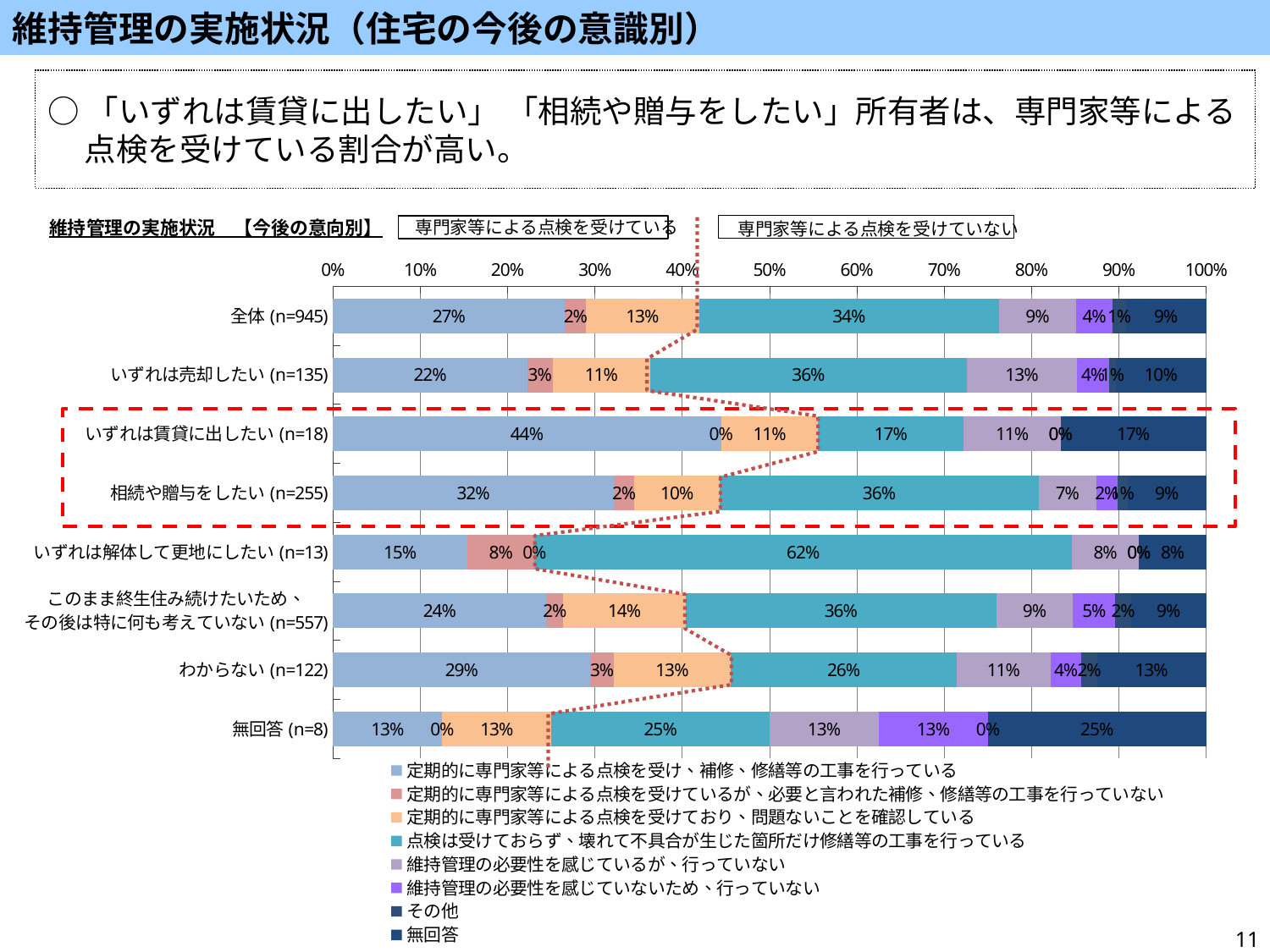
How many series does the legend list? 8 What kind of chart is shown on the slide? Stacked bar chart Which is larger for 点検は受けておらず、壊れて不具合が生じた箇所だけ修繕等の工事を行っている: 全体 (n=945) or 相続や贈与をしたい (n=255)? 相続や贈与をしたい (n=255) Which category has the highest value for 点検は受けておらず、壊れて不具合が生じた箇所だけ修繕等の工事を行っている? いずれは解体して更地にしたい (n=13) What is the value for 全体 (n=945) in the series 定期的に専門家等による点検を受け、補修、修繕等の工事を行っている? 27% What is the difference between いずれは賃貸に出したい (n=18) and 全体 (n=945) in the series 定期的に専門家等による点検を受け、補修、修繕等の工事を行っている? 17 percentage points What is the value for わからない (n=122) in the series 点検は受けておらず、壊れて不具合が生じた箇所だけ修繕等の工事を行っている? 26% What is the value for いずれは解体して更地にしたい (n=13) in the series 点検は受けておらず、壊れて不具合が生じた箇所だけ修繕等の工事を行っている? 62% Which category has the highest value for 定期的に専門家等による点検を受け、補修、修繕等の工事を行っている? いずれは賃貸に出したい (n=18) What is the title of the chart? 維持管理の実施状況 【今後の意向別】 What is the value for いずれは売却したい (n=135) in the series 維持管理の必要性を感じているが、行っていない? 13% How many categories (bars) are shown in the chart? 8